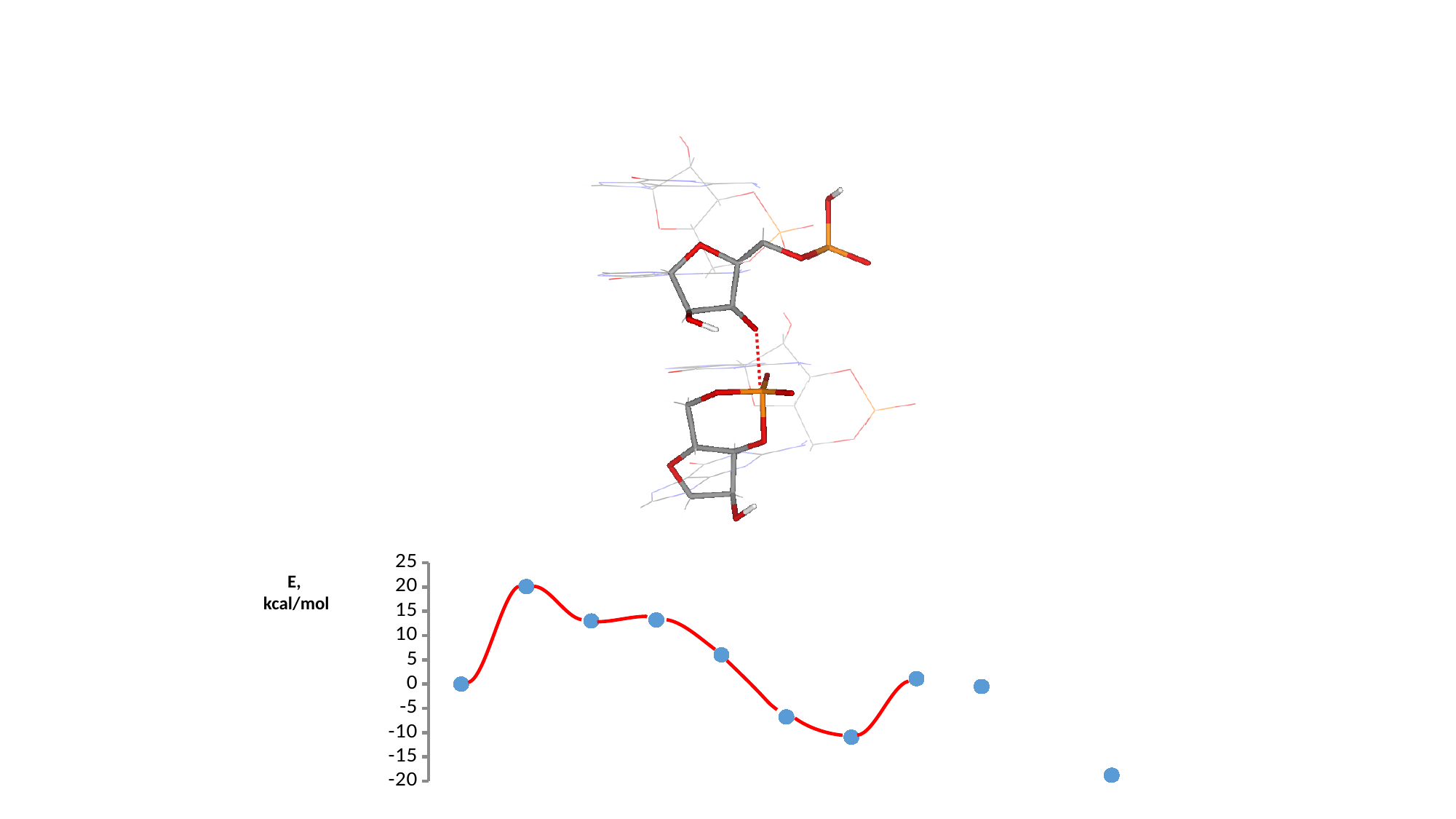
Is the value of the fifth point from the left greater or less than 10? less Does the energy rise or fall between the fifth and seventh points from the left? fall Which data point has the highest energy value: the second point from the left or the last point on the right? the second point from the left Does the energy rise or fall between the first and second points from the left? rise Is the value of the rightmost point greater or less than -15? less What is the highest tick value shown on the vertical axis? 25 How many data points are plotted on the chart? 10 What kind of chart is shown at the bottom of the slide? line chart with markers Is the value of the seventh point from the left greater or less than -5? less Which point is the lowest on the chart: the seventh point from the left or the rightmost point? the rightmost point What is the label on the vertical axis of the chart? E, kcal/mol